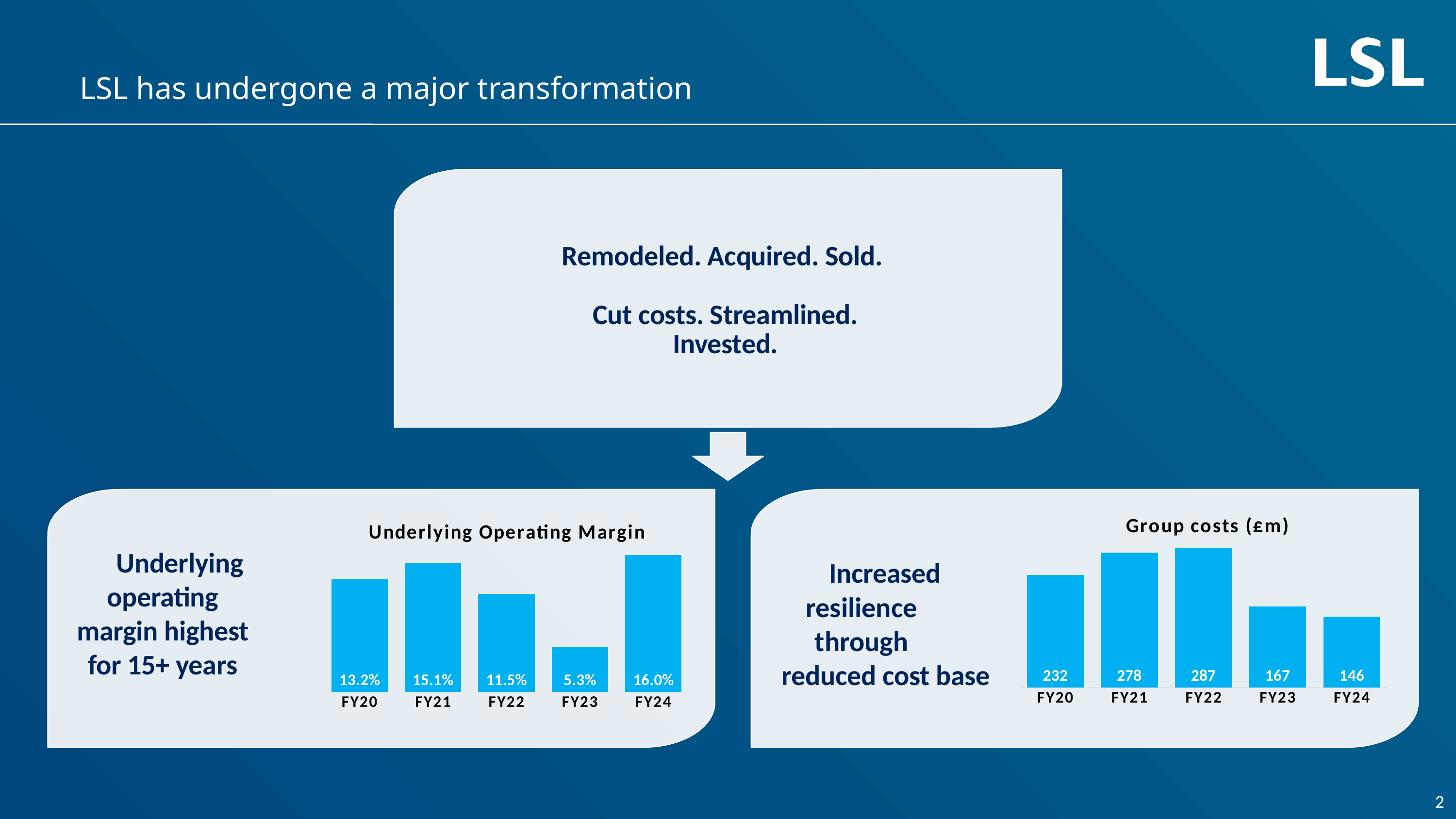
In the Group costs (£m) chart, do the values rise or fall from FY22 to FY24? fall In the Group costs (£m) chart, which year has the lowest group costs? FY24 In the Underlying Operating Margin chart, how many years are shown? 5 In the Underlying Operating Margin chart, which year has the lowest margin? FY23 In the Group costs (£m) chart, which year has the highest group costs? FY22 In the Underlying Operating Margin chart, what is the value for FY23? 5.3% In the Group costs (£m) chart, what is the difference between the FY21 and FY24 values? 132 In the Group costs (£m) chart, what is the value for FY22? 287 In the Underlying Operating Margin chart, what is the difference between the FY24 and FY23 values? 10.7% In the Underlying Operating Margin chart, which year has the highest margin? FY24 What kind of chart is the Group costs (£m) chart? bar chart In the Group costs (£m) chart, which is larger, the value for FY20 or the value for FY23? FY20